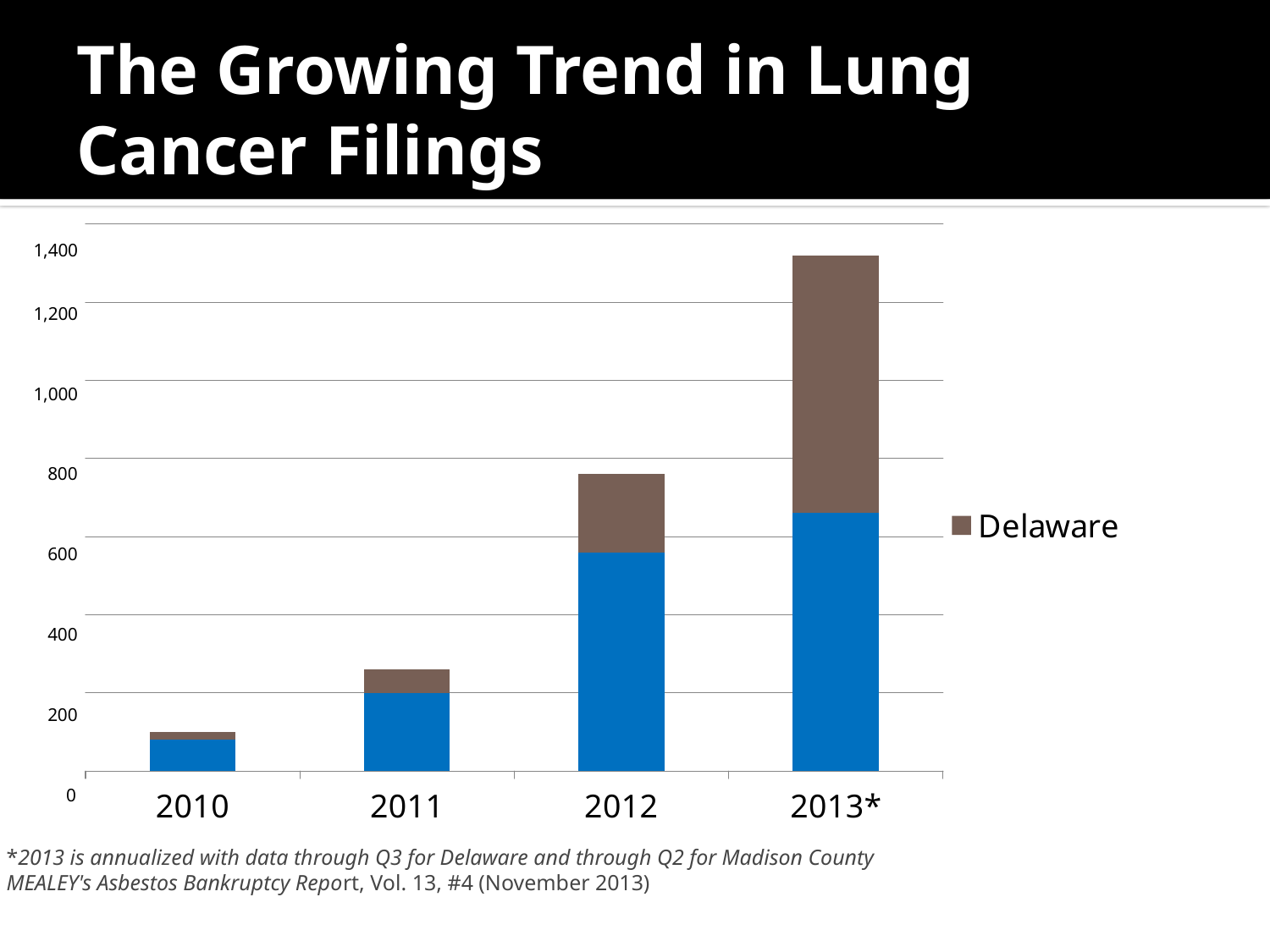
Is the total height of the 2013* bar greater or less than 1,200? greater Which year has the larger stacked bar, 2011 or 2012? 2012 Which year has the tallest stacked bar? 2013* Is the total height of the 2010 bar greater or less than 200? less How many series does the chart's legend list? 1 How many years are shown on the x axis of the chart? 4 Which series is named in the chart's legend? Delaware Do the total filings rise or fall from 2010 to 2013*? Rise What kind of chart is shown on the slide? Stacked bar chart Which year has the shortest stacked bar? 2010 Is the total height of the 2011 bar greater or less than 400? less What colour represents Delaware in the chart? Brown